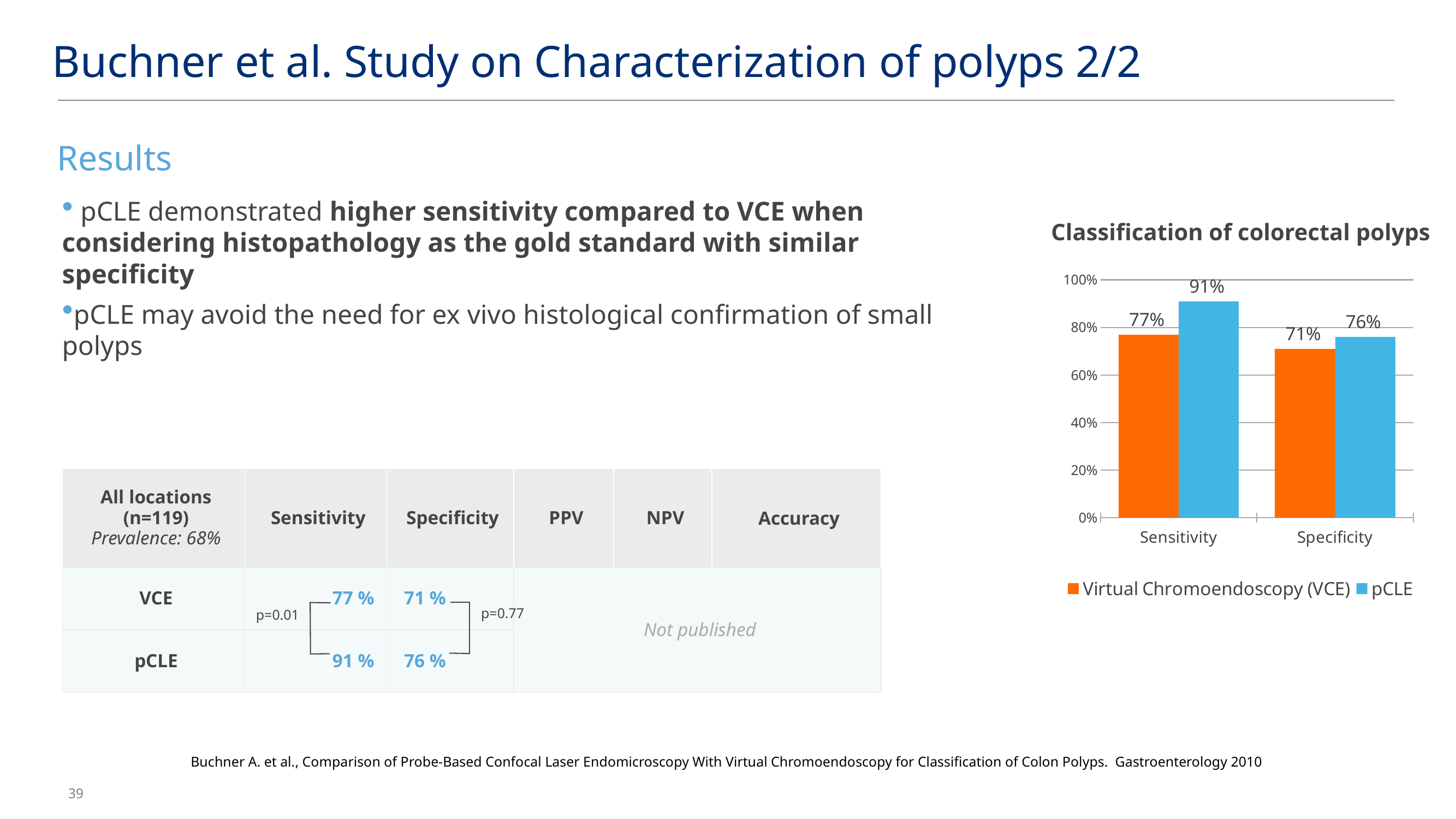
What is the difference between the pCLE and VCE values for Sensitivity? 14% How many series does the chart legend list? 2 What is the pCLE value for Sensitivity in the chart? 91% What is the Virtual Chromoendoscopy (VCE) value for Specificity in the chart? 71% What is the VCE value for Sensitivity in the chart? 77% What is the title of the chart? Classification of colorectal polyps What is the pCLE value for Specificity in the chart? 76% Which bar is the lowest in the chart? VCE Specificity How many categories are shown on the x axis of the chart? 2 What is the difference between the pCLE and VCE values for Specificity? 5% Which series has the highest value in the chart? pCLE Which is larger for Sensitivity, VCE or pCLE? pCLE